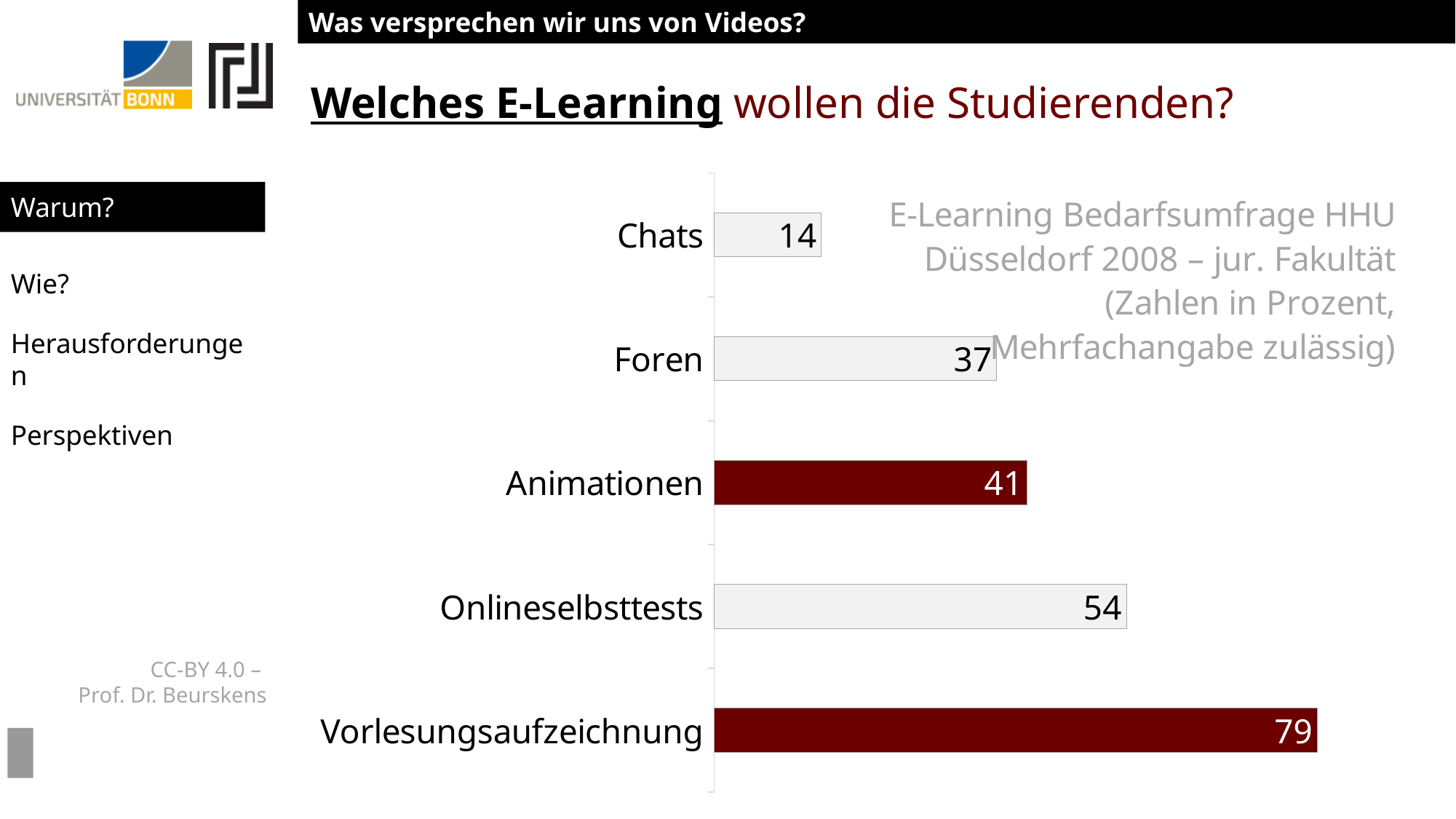
Which has a larger value, Onlineselbsttests or Animationen? Onlineselbsttests What kind of chart is shown on the slide? Bar chart What is the value for Chats? 14 What is the value for Foren? 37 What is the difference between the values for Animationen and Foren? 4 What is the difference between the values for Vorlesungsaufzeichnung and Onlineselbsttests? 25 Which category has the lowest value? Chats Which category has the highest value? Vorlesungsaufzeichnung How many categories are shown in the chart? 5 What is the value for Vorlesungsaufzeichnung? 79 Which categories are highlighted with dark red bars? Animationen and Vorlesungsaufzeichnung What is the value for Onlineselbsttests? 54